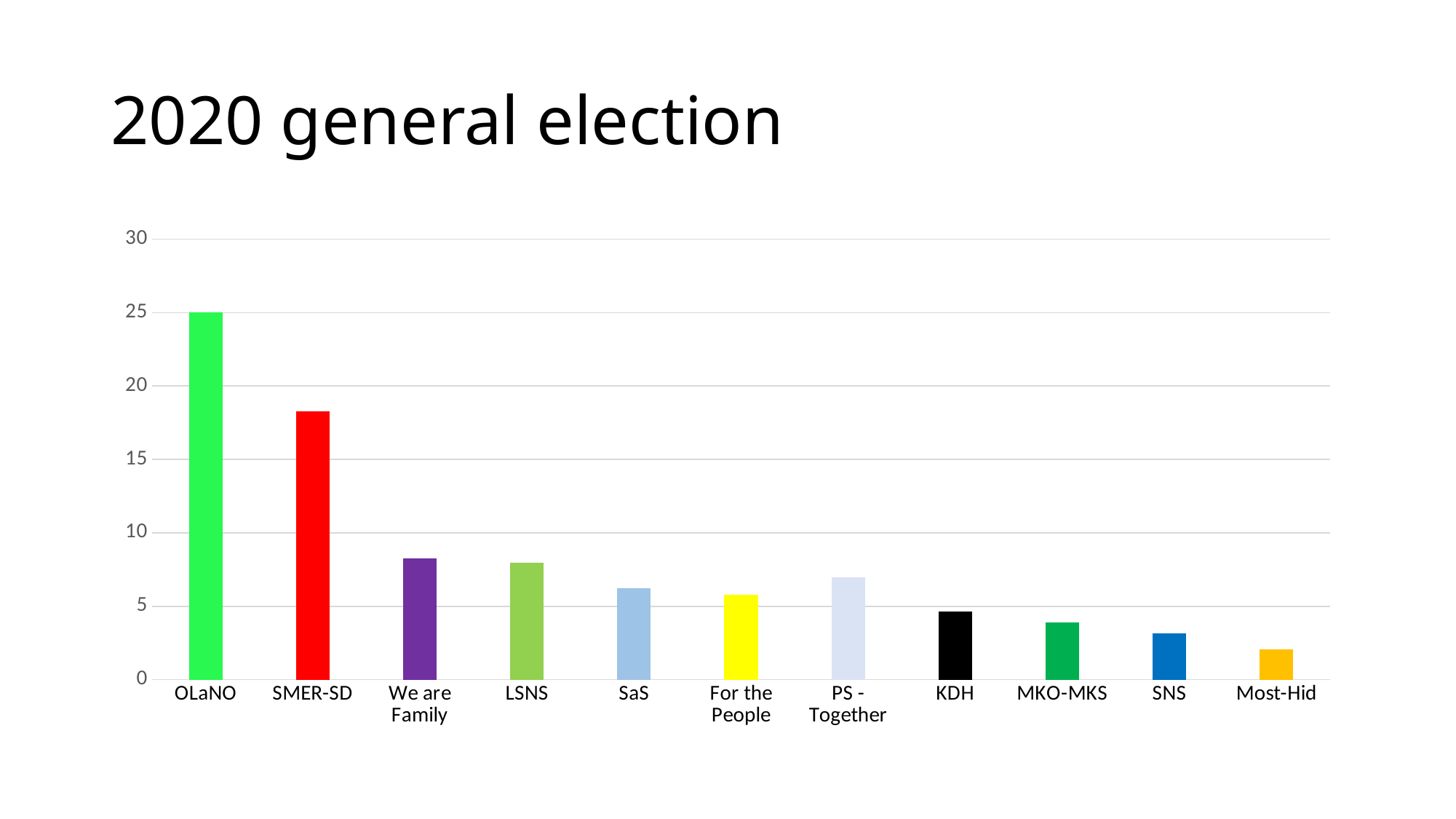
What kind of chart is shown on the slide? bar chart Do the values generally rise or fall moving from left to right along the x axis? fall Which party has the highest bar on the chart? OLaNO Is the value for PS - Together greater or less than 5? greater What is the value for OLaNO? 25 Is the value for KDH greater or less than 5? less Is the value for LSNS greater or less than 10? less How many parties (categories) are shown on the chart? 11 Which is larger, the value for SMER-SD or the value for We are Family? SMER-SD What colour is the bar for OLaNO? green Which party has the lowest bar on the chart? Most-Hid